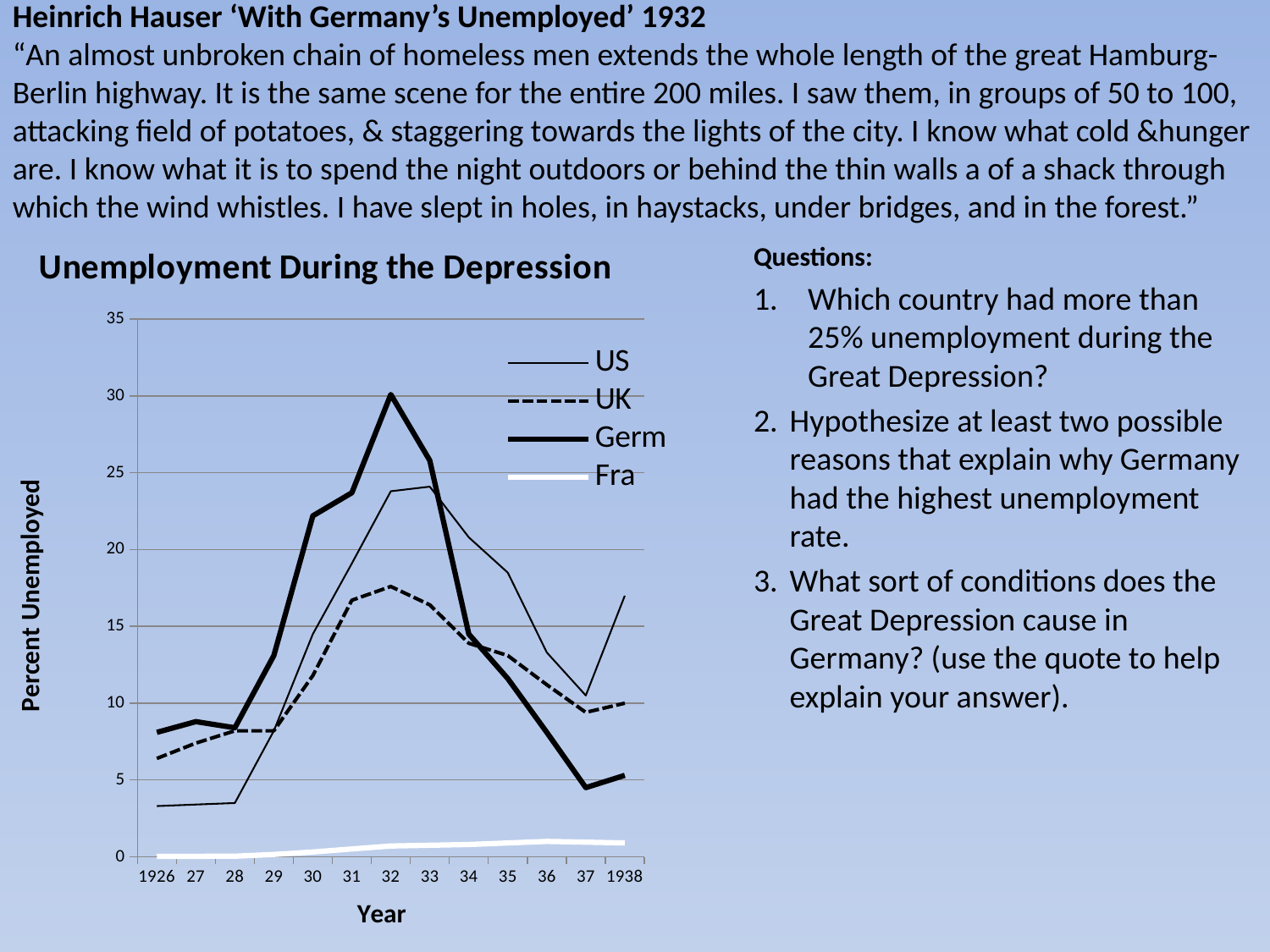
What kind of chart is shown on the slide? line chart How many series does the legend of the chart list? 4 Is the value for US in 1926 greater or less than 5? less Which country's line stays lowest across the whole chart? Fra Does the Germ line rise or fall between 1932 and 1937? fall Is the value for Germ in 1932 greater or less than 25? greater In which year does the Germ line reach its peak? 32 In 1936, which is larger, the value for US or the value for Germ? US Which country's line reaches the highest unemployment value on the chart? Germ What is the title of the chart? Unemployment During the Depression Is the value for UK in 1932 greater or less than 20? less How many years are marked along the x axis of the chart? 13